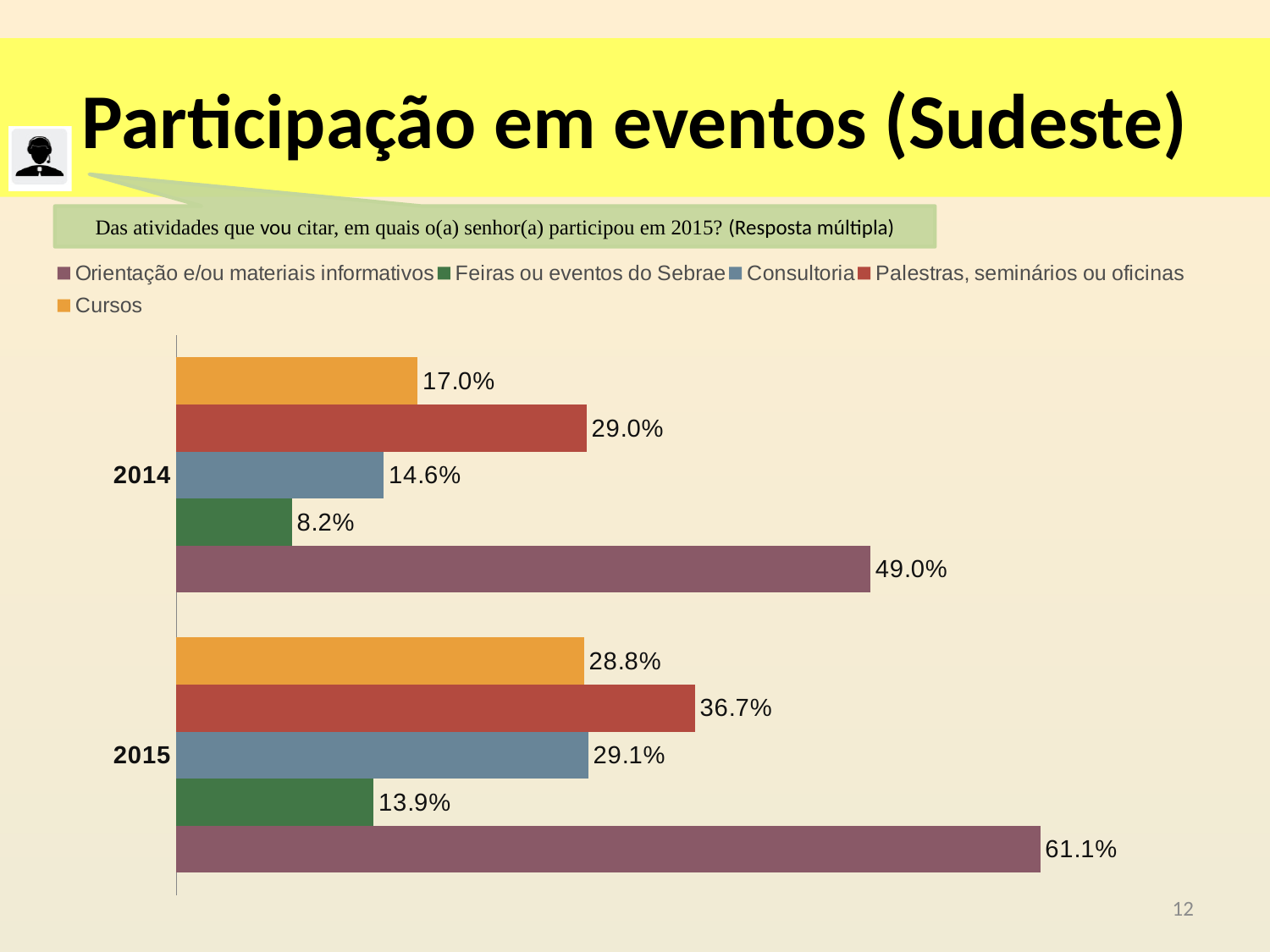
What is the value for Cursos in 2014? 17.0% What is the value for Consultoria in 2015? 29.1% Which series has the lowest value in 2014? Feiras ou eventos do Sebrae How many series does the legend list? 5 What is the value for Orientação e/ou materiais informativos in 2015? 61.1% What is the value for Feiras ou eventos do Sebrae in 2014? 8.2% Did the value for Feiras ou eventos do Sebrae rise or fall from 2014 to 2015? Rise Which is larger: Cursos in 2015 or Consultoria in 2015? Consultoria in 2015 What kind of chart is shown on the slide? Bar chart What is the difference between the Palestras, seminários ou oficinas values for 2015 and 2014? 7.7% How many year categories are shown on the chart? 2 Which series has the highest value in 2015? Orientação e/ou materiais informativos